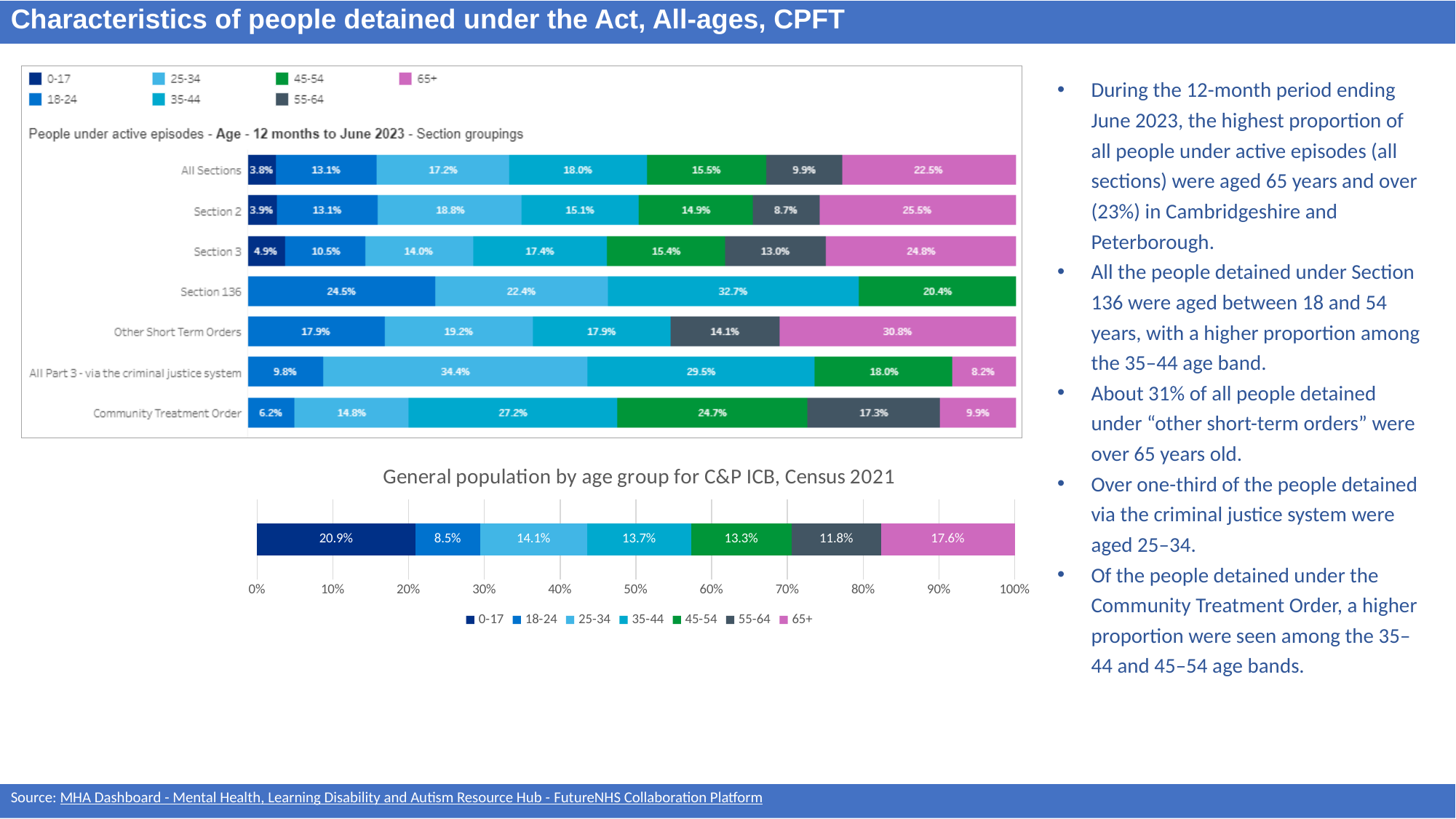
In the top chart 'People under active episodes - Age - 12 months to June 2023 - Section groupings', what is the 35-44 value for Section 136? 32.7% In the 'General population by age group for C&P ICB, Census 2021' chart, which age group has the highest share? 0-17 What type of chart is the 'General population by age group for C&P ICB, Census 2021' chart? Stacked bar chart In the top chart 'People under active episodes - Age - 12 months to June 2023 - Section groupings', what is the difference between the 25-34 value for All Part 3 - via the criminal justice system and the 25-34 value for All Sections? 17.2% In the 'General population by age group for C&P ICB, Census 2021' chart, what is the value for the 0-17 age group? 20.9% In the 'General population by age group for C&P ICB, Census 2021' chart, what is the difference between the 65+ and 55-64 values? 5.8% In the top chart 'People under active episodes - Age - 12 months to June 2023 - Section groupings', which section grouping has the highest 65+ share? Other Short Term Orders In the 'General population by age group for C&P ICB, Census 2021' chart, which age group has the lowest share? 18-24 In the top chart 'People under active episodes - Age - 12 months to June 2023 - Section groupings', how many section groupings are shown? 7 In the top chart 'People under active episodes - Age - 12 months to June 2023 - Section groupings', which is larger for Community Treatment Order: the 35-44 share or the 45-54 share? 35-44 In the top chart 'People under active episodes - Age - 12 months to June 2023 - Section groupings', what is the 65+ value for All Sections? 22.5% In the 'General population by age group for C&P ICB, Census 2021' chart, how many age groups does the legend list? 7